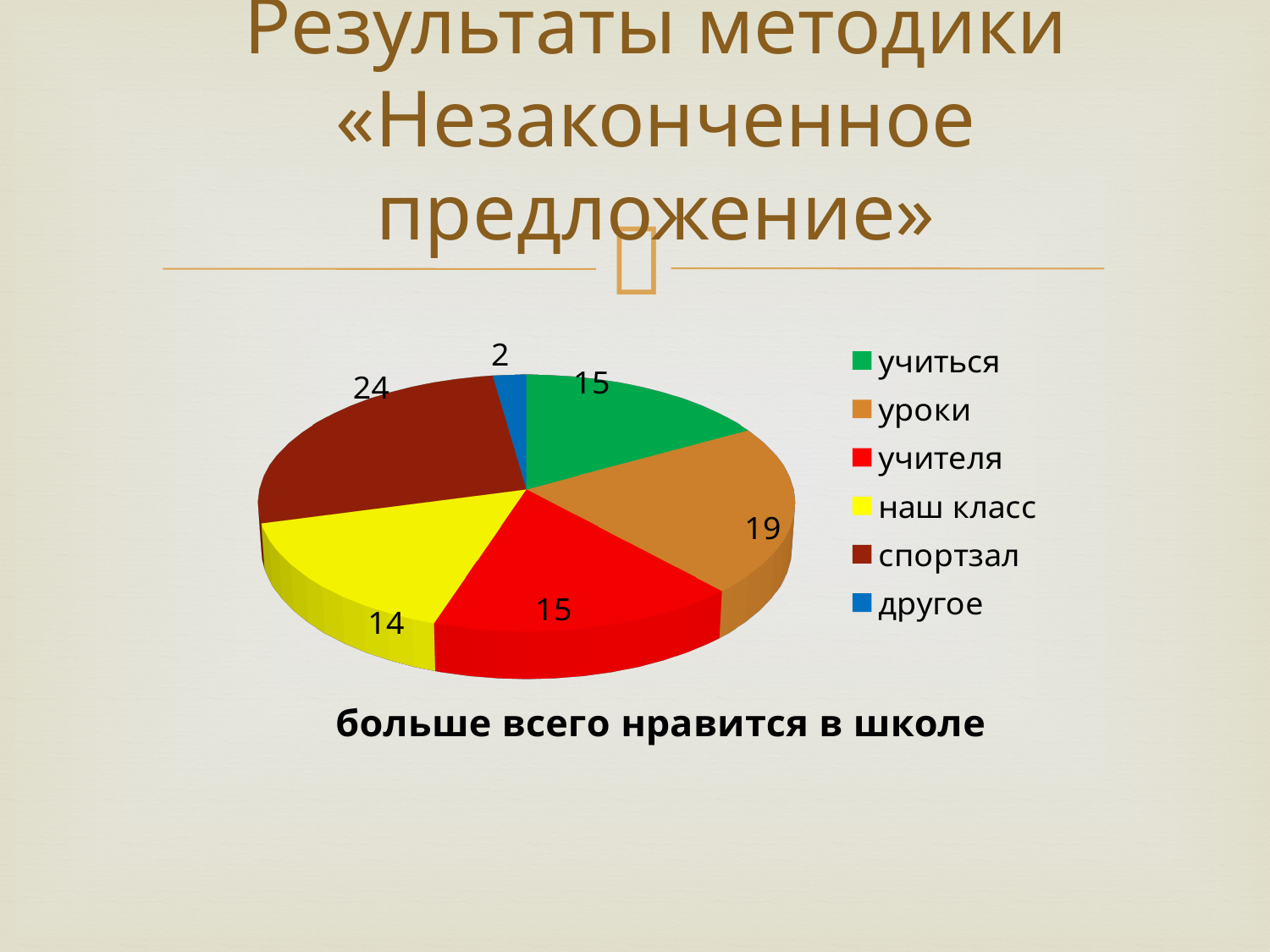
Which is larger, the value for уроки or the value for наш класс? уроки What is the value for спортзал in the pie chart? 24 What is the value for наш класс in the pie chart? 14 How many categories does the pie chart have? 6 Which category has the smallest slice in the pie chart? другое What is the title of the pie chart? больше всего нравится в школе What is the difference between the values for спортзал and уроки? 5 Which category has the largest slice in the pie chart? спортзал What is the value for другое in the pie chart? 2 What is the total of all the values shown in the pie chart? 89 What kind of chart is shown on the slide? pie chart What is the value for уроки in the pie chart? 19